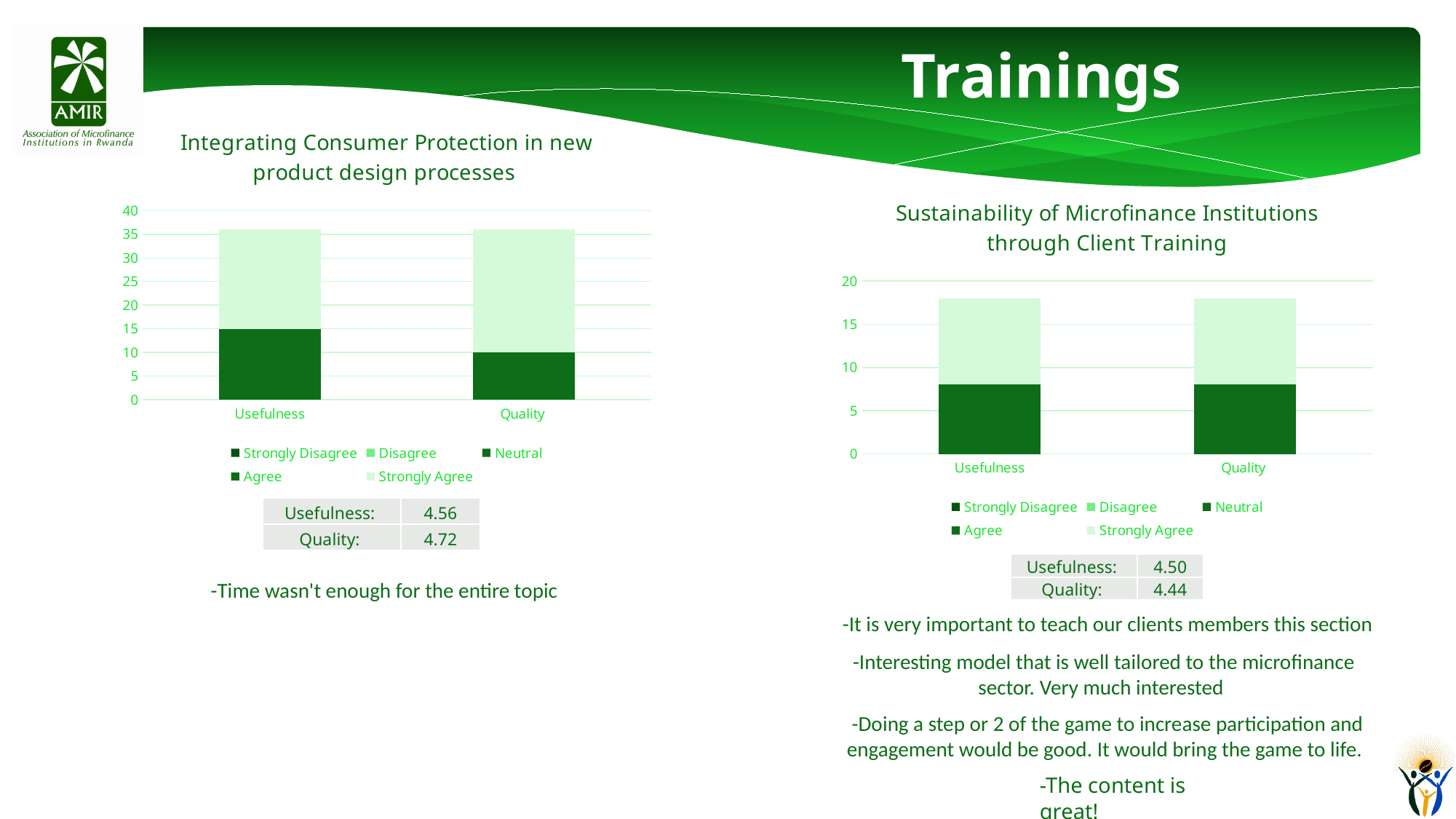
On the chart titled 'Integrating Consumer Protection in new product design processes', how many categories are shown on the x axis? 2 On the chart titled 'Sustainability of Microfinance Institutions through Client Training', is the Agree segment for Usefulness greater or less than 10? less On the chart titled 'Integrating Consumer Protection in new product design processes', how many series does the legend list? 5 On the chart titled 'Sustainability of Microfinance Institutions through Client Training', which legend entry is shown in the lightest green? Strongly Agree On the chart titled 'Integrating Consumer Protection in new product design processes', what kind of chart is shown? bar chart On the chart titled 'Integrating Consumer Protection in new product design processes', what is the value of the Agree segment for Quality? 10 On the chart titled 'Integrating Consumer Protection in new product design processes', is the Agree segment larger for Usefulness or for Quality? Usefulness On the chart titled 'Integrating Consumer Protection in new product design processes', is the total height of the Usefulness bar greater or less than 30? greater On the chart titled 'Sustainability of Microfinance Institutions through Client Training', how many series does the legend list? 5 On the chart titled 'Sustainability of Microfinance Institutions through Client Training', is the total height of the Quality bar greater or less than 15? greater